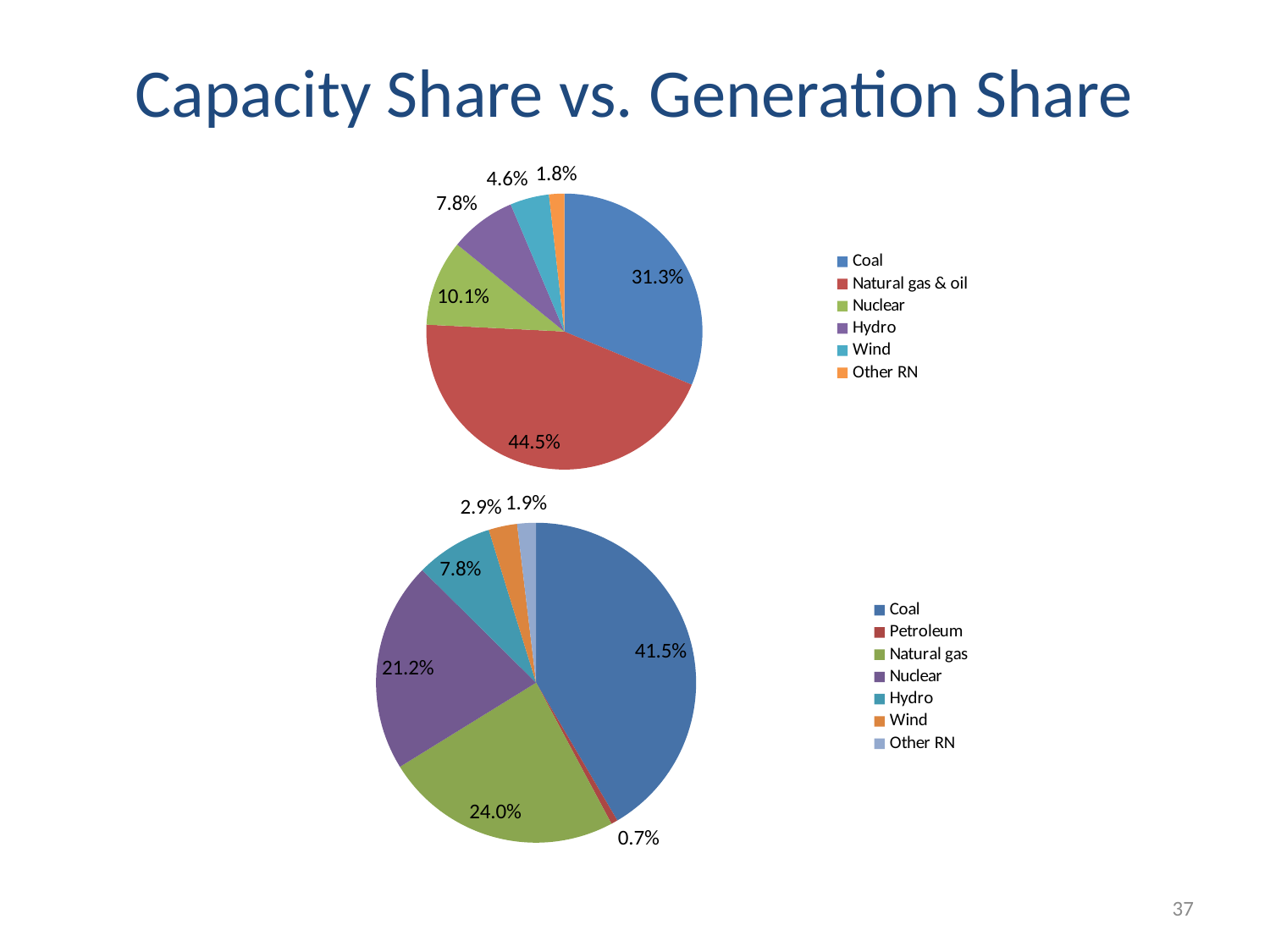
In the bottom pie chart, which category has the largest slice? Coal What type of chart is shown at the bottom of the slide? Pie chart In the top pie chart, which category has the largest slice? Natural gas & oil In the bottom pie chart, what share does Petroleum have? 0.7% In the bottom pie chart, what share does Coal have? 41.5% In the top pie chart, what share does Natural gas & oil have? 44.5% In the top pie chart, which category has the smallest slice? Other RN In the top pie chart, what is the difference between the Natural gas & oil share and the Coal share? 13.2% In the top pie chart, what share does Nuclear have? 10.1% In the bottom pie chart, which is larger, Natural gas or Nuclear? Natural gas How many categories does the legend of the top pie chart list? 6 How many categories does the legend of the bottom pie chart list? 7